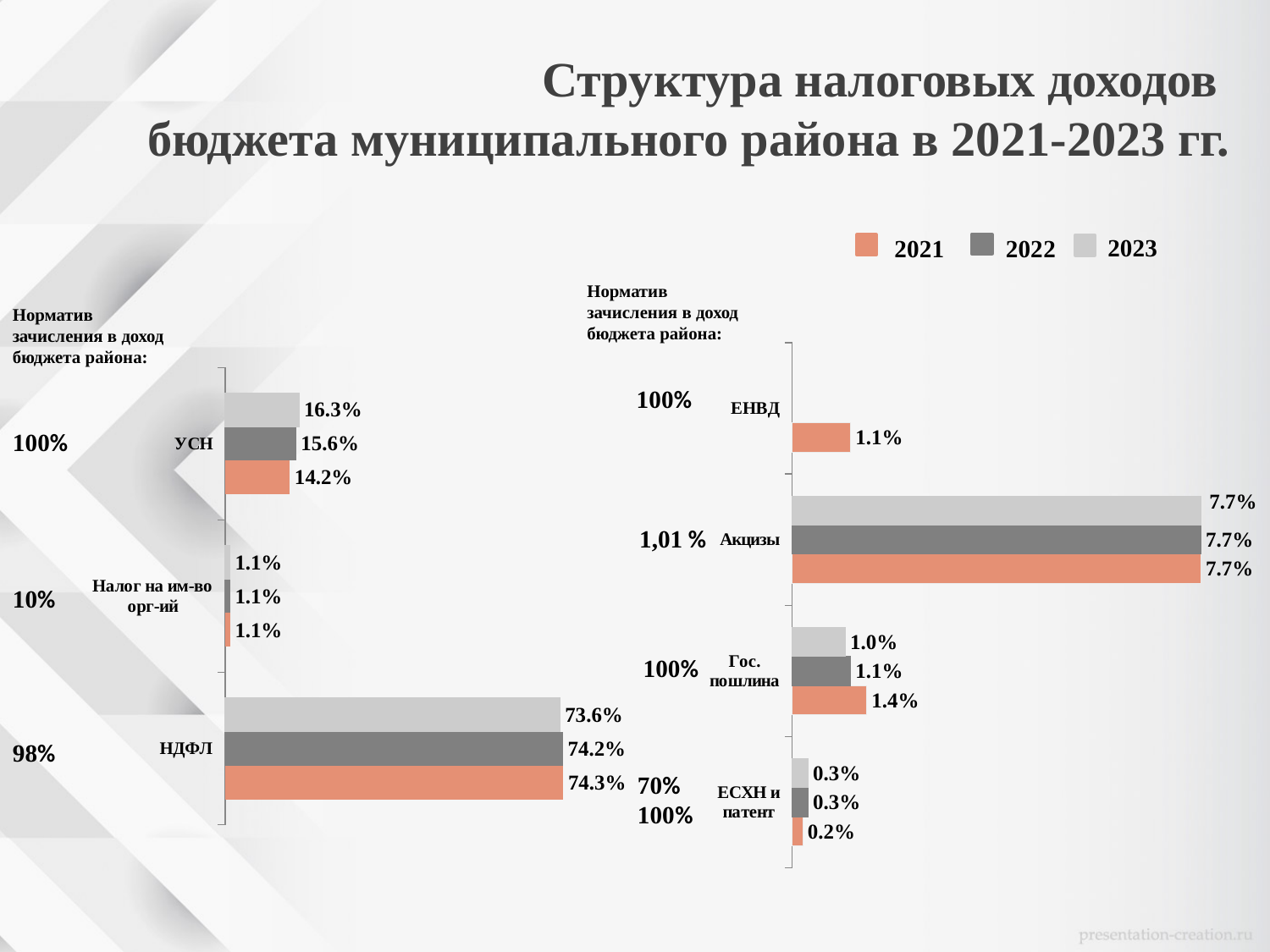
On the left chart, what is the value for УСН in 2023? 16.3% On the right chart, what is the value for ЕНВД in 2021? 1.1% What kind of chart is the left chart? Bar chart On the right chart, which category has the lowest value in 2021? ЕСХН и патент On the right chart, which is larger for Гос. пошлина: the 2021 value or the 2023 value? 2021 Which colour represents 2021 in the legend? Orange On the left chart, what is the difference between the 2023 and 2021 values for УСН? 2.1% How many series does the legend list? 3 On the left chart, which category has the highest value in 2023? НДФЛ On the left chart, what is the value for НДФЛ in 2021? 74.3% On the right chart, what is the value for Гос. пошлина in 2022? 1.1% How many categories are shown on the right chart? 4